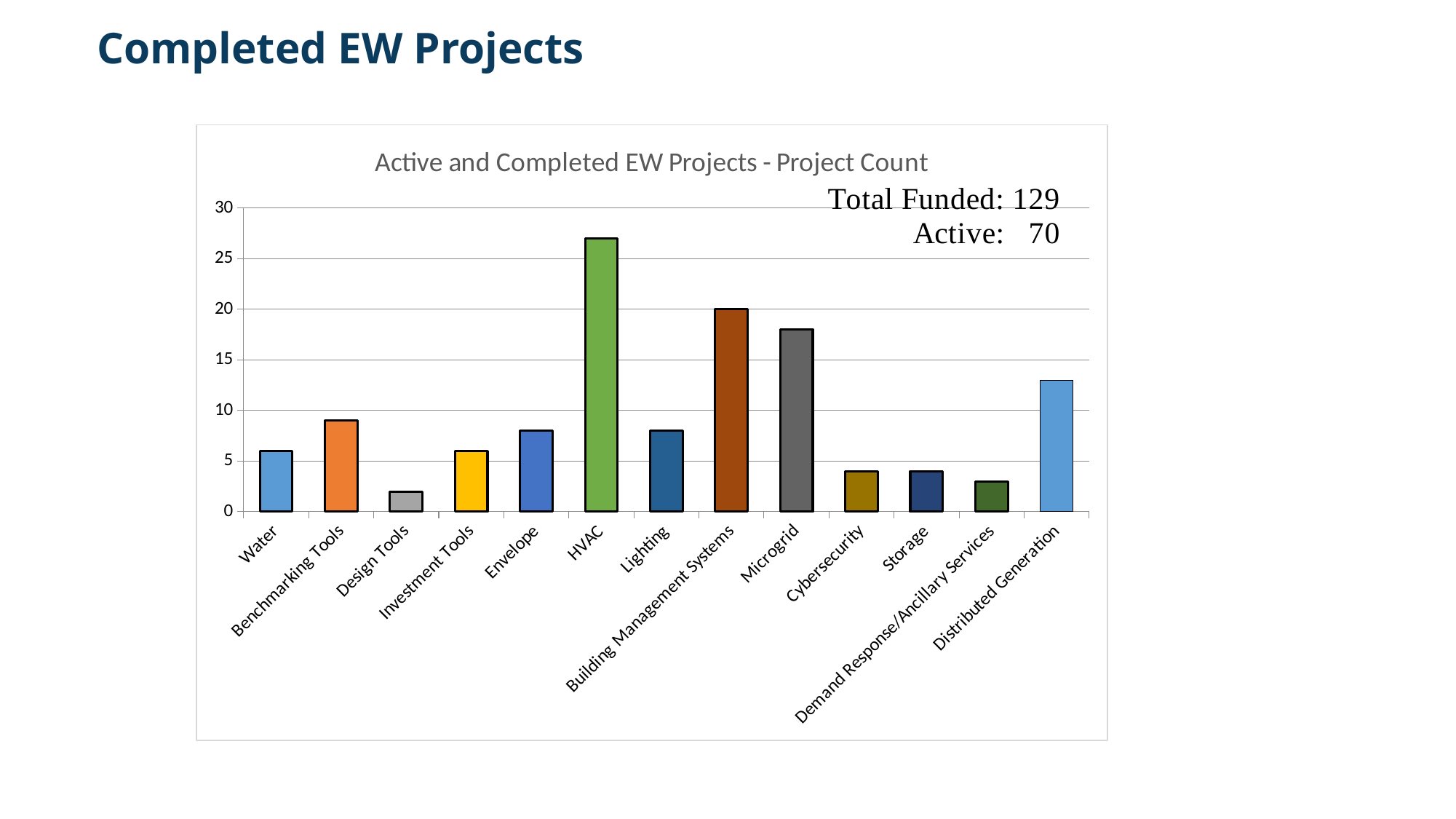
What is the project count for Building Management Systems? 20 Which has a larger project count, Microgrid or Distributed Generation? Microgrid Which category has the lowest project count? Design Tools According to the text on the chart, what is the Total Funded project count? 129 How many categories are shown on the x axis of the chart? 13 Is the value for Microgrid greater or less than 15? greater Which category has the highest project count? HVAC What type of chart is shown on the slide? bar chart Is the value for HVAC greater or less than 25? greater Is the value for Benchmarking Tools greater or less than 10? less What is the title of the chart? Active and Completed EW Projects - Project Count